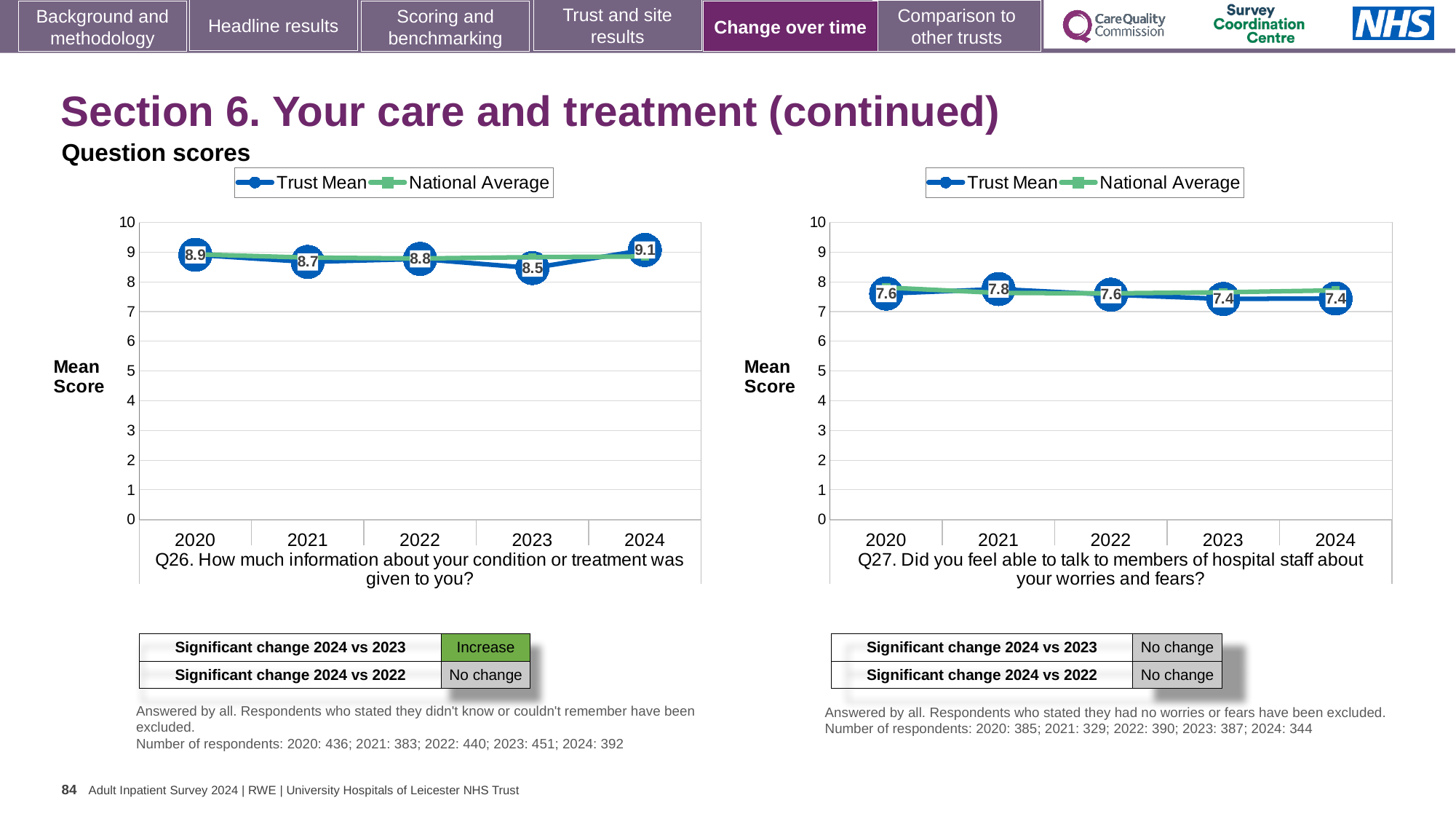
How many series does the legend of the Q26 chart list? 2 In the Q27 chart, which year has the highest Trust Mean score? 2021 In the Q26 chart, which year has the highest Trust Mean score? 2024 In the Q27 chart, what is the Trust Mean score for 2024? 7.4 In the Q26 chart, what is the Trust Mean score for 2023? 8.5 What type of chart is used for Q26? Line chart In the Q26 chart, what is the Trust Mean score for 2024? 9.1 In the Q26 chart, what is the difference between the Trust Mean scores for 2024 and 2023? 0.6 How many years are plotted on the x axis of the Q27 chart? 5 In the Q27 chart, what is the Trust Mean score for 2021? 7.8 In the Q27 chart, is the Trust Mean score for 2020 larger or smaller than the score for 2023? larger In the Q26 chart, which year has the lowest Trust Mean score? 2023